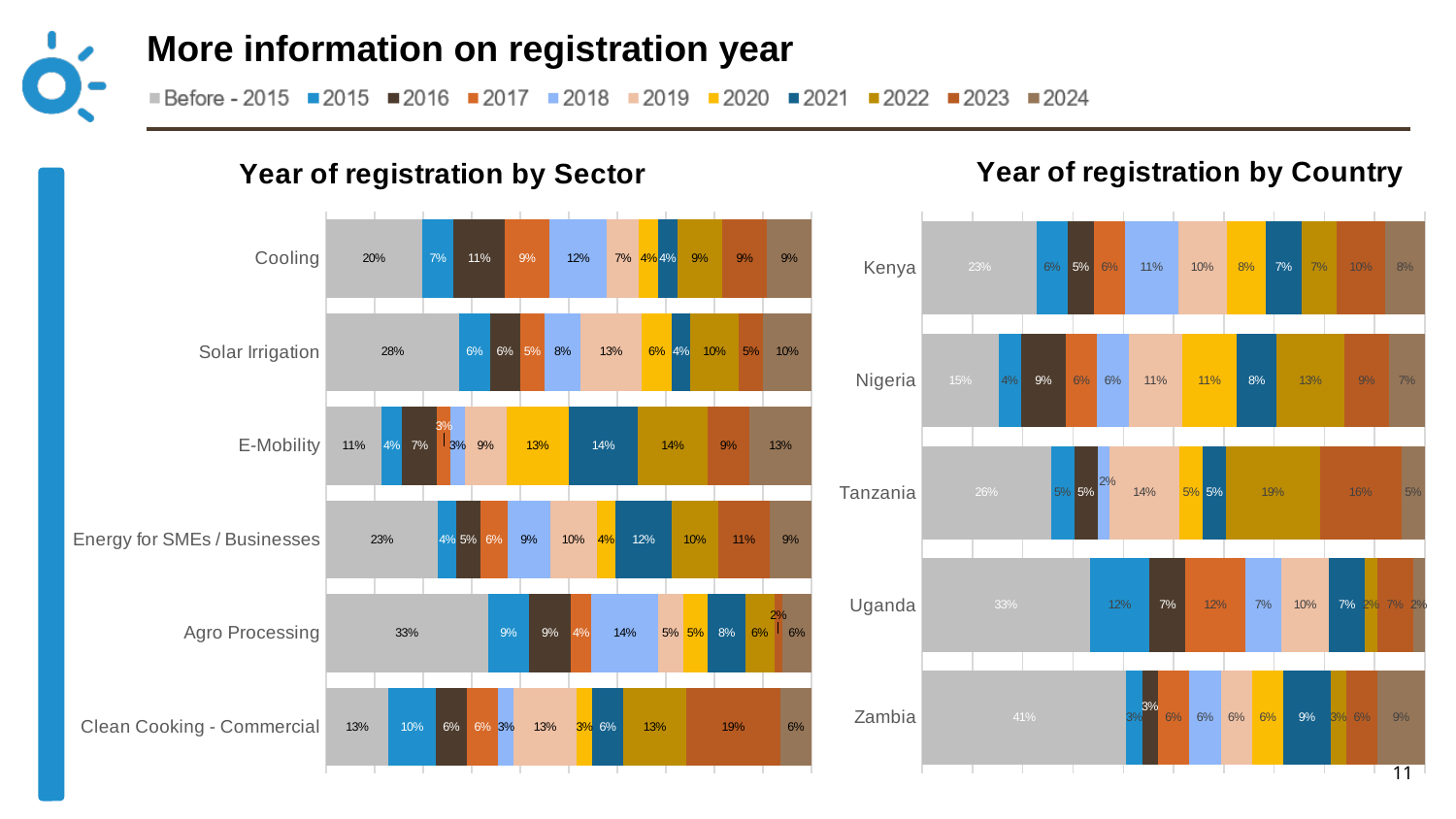
In the 'Year of registration by Sector' chart, what is the 2023 value for Clean Cooking - Commercial? 19% How many countries are shown in the 'Year of registration by Country' chart? 5 How many sectors are shown in the 'Year of registration by Sector' chart? 6 In the 'Year of registration by Sector' chart, which sector has the lowest 'Before - 2015' share? E-Mobility In the 'Year of registration by Country' chart, what is the 2022 value for Nigeria? 13% What kind of chart is the 'Year of registration by Sector' chart? Stacked bar chart In the 'Year of registration by Sector' chart, which sector has the highest 'Before - 2015' share? Agro Processing How many series does the legend at the top of the slide list? 11 In the 'Year of registration by Sector' chart, what is the difference between the 'Before - 2015' values for Solar Irrigation and Cooling? 8 percentage points In the 'Year of registration by Country' chart, which has the larger 'Before - 2015' value, Kenya or Nigeria? Kenya In the 'Year of registration by Country' chart, which country has the highest 'Before - 2015' share? Zambia In the 'Year of registration by Sector' chart, what is the 'Before - 2015' value for Cooling? 20%